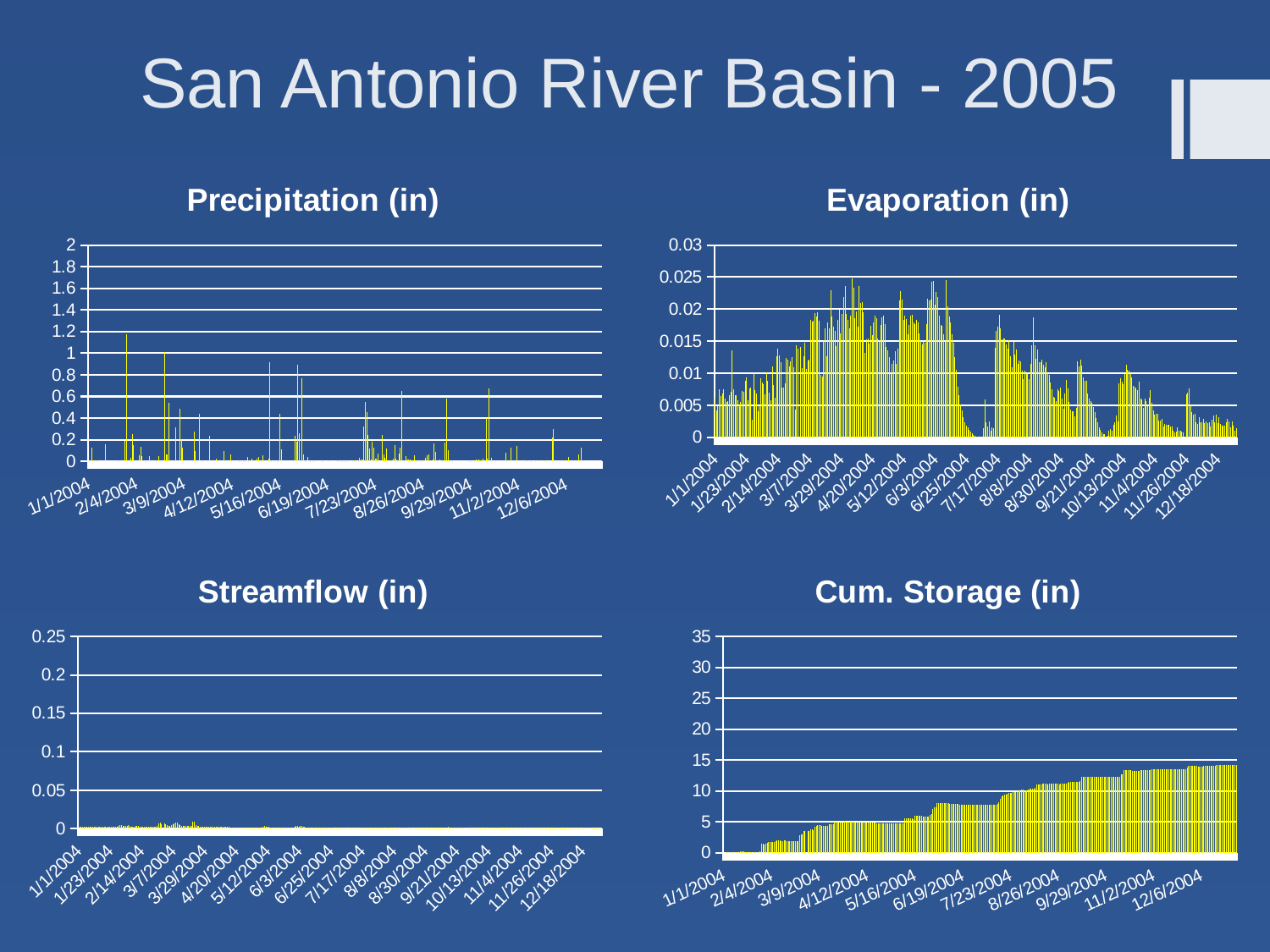
In the Cum. Storage (in) chart, do the values rise or fall from 1/1/2004 to 12/6/2004? rise In the Evaporation (in) chart, is the value on 1/1/2004 greater or less than 0.015? less In the Precipitation (in) chart, what is the highest value shown on the y axis? 2 What kind of chart is the Cum. Storage (in) chart? bar chart In the Evaporation (in) chart, do the values rise or fall from 6/3/2004 to 12/18/2004? fall In the Cum. Storage (in) chart, is the value on 12/6/2004 greater or less than 10? greater How many charts are shown on the slide? 4 What kind of chart is the Evaporation (in) chart? bar chart In the Cum. Storage (in) chart, is the value on 1/1/2004 greater or less than 5? less